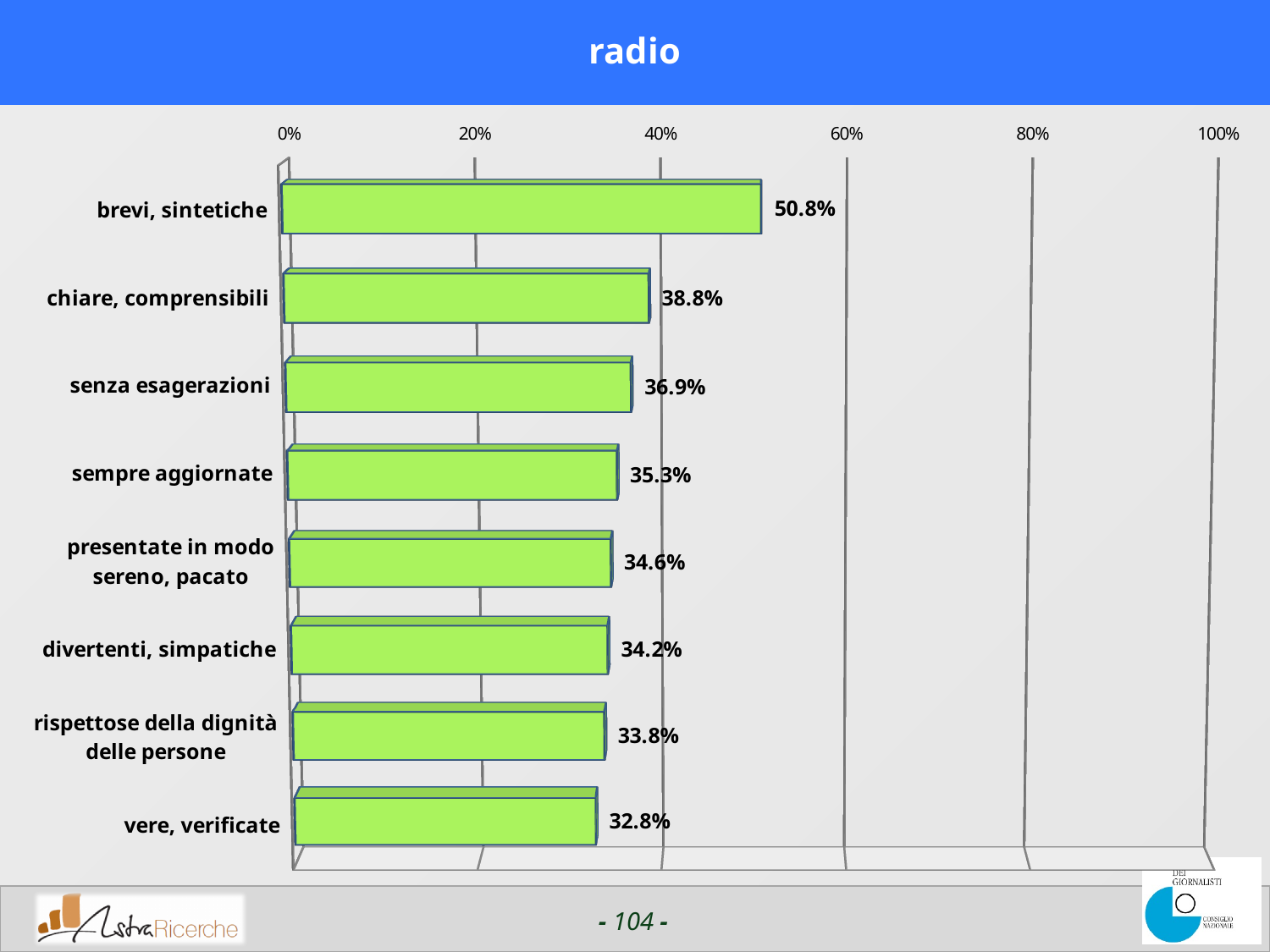
Is the value for "vere, verificate" greater or less than 40%? less Is the value for "brevi, sintetiche" greater or less than 40%? greater Which is larger, the value for "senza esagerazioni" or the value for "divertenti, simpatiche"? senza esagerazioni What is the value for "sempre aggiornate"? 35.3% Which category has the highest value? brevi, sintetiche Which category has the lowest value? vere, verificate What is the difference between the values for "brevi, sintetiche" and "chiare, comprensibili"? 12.0% How many categories are shown in the chart? 8 What is the value for "rispettose della dignità delle persone"? 33.8% What kind of chart is shown on the slide? bar chart What is the value for "brevi, sintetiche"? 50.8% What is the title of the chart? radio